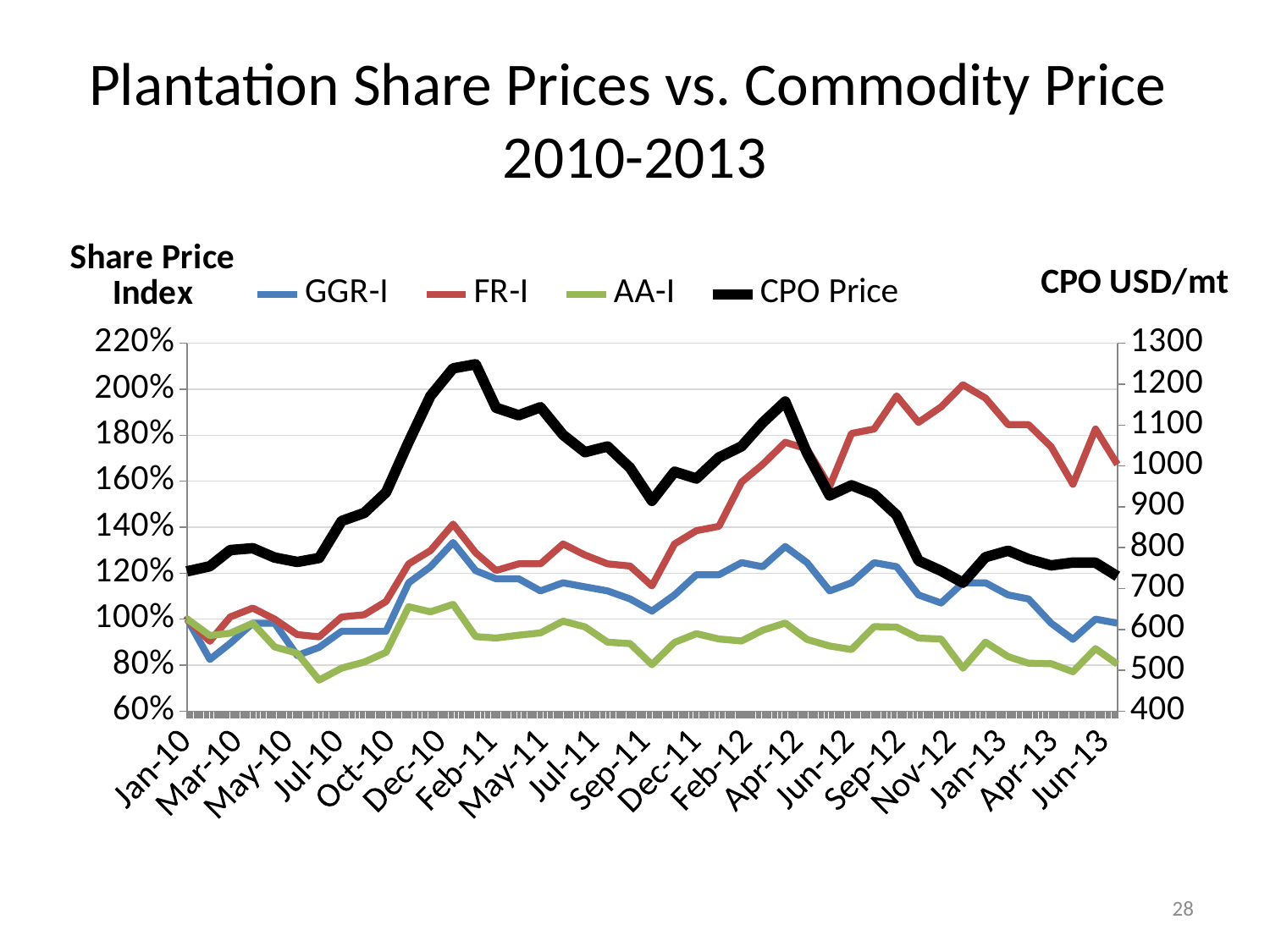
Which series has the lowest value at Jun-13? AA-I Does the CPO Price rise or fall between Apr-12 and Nov-12? fall Which series reaches the highest share price index value on the chart? FR-I At Jan-13, which is higher, FR-I or AA-I? FR-I What is the label of the right-hand axis? CPO USD/mt Is the CPO Price at Feb-11 greater or less than 1100? greater What is the title of the chart? Plantation Share Prices vs. Commodity Price 2010-2013 Is the FR-I value at Jan-13 greater or less than 180%? greater What kind of chart is shown on the slide? line chart Is the AA-I value at Jul-10 greater or less than 80%? less How many series does the legend list? 4